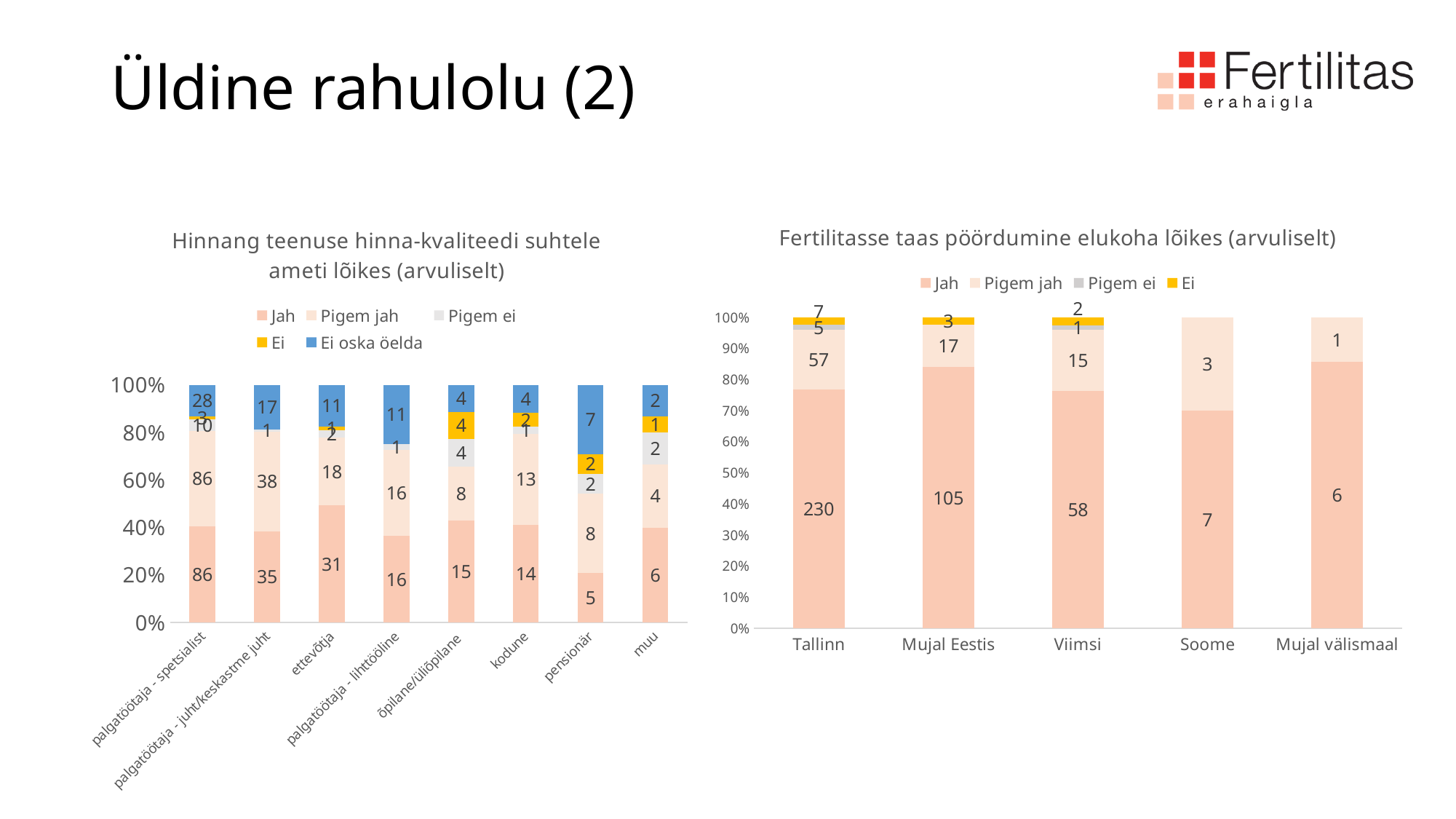
In the chart 'Hinnang teenuse hinna-kvaliteedi suhtele ameti lõikes (arvuliselt)', how many series does the legend list? 5 In the chart 'Fertilitasse taas pöördumine elukoha lõikes (arvuliselt)', what is the 'Jah' value for Tallinn? 230 In the chart 'Hinnang teenuse hinna-kvaliteedi suhtele ameti lõikes (arvuliselt)', what is the 'Jah' value for 'ettevõtja'? 31 In the chart 'Fertilitasse taas pöördumine elukoha lõikes (arvuliselt)', what is the 'Pigem jah' value for Viimsi? 15 In the chart 'Hinnang teenuse hinna-kvaliteedi suhtele ameti lõikes (arvuliselt)', which is larger: the 'Pigem jah' value for 'pensionär' or the 'Pigem jah' value for 'muu'? pensionär What type of chart is 'Hinnang teenuse hinna-kvaliteedi suhtele ameti lõikes (arvuliselt)'? Stacked bar chart In the chart 'Fertilitasse taas pöördumine elukoha lõikes (arvuliselt)', how many series does the legend list? 4 In the chart 'Fertilitasse taas pöördumine elukoha lõikes (arvuliselt)', how many locations are shown on the x axis? 5 In the chart 'Fertilitasse taas pöördumine elukoha lõikes (arvuliselt)', which location has the highest 'Jah' value? Tallinn In the chart 'Hinnang teenuse hinna-kvaliteedi suhtele ameti lõikes (arvuliselt)', what is the difference between the 'Jah' values for 'palgatöötaja - spetsialist' and 'palgatöötaja - juht/keskastme juht'? 51 In the chart 'Hinnang teenuse hinna-kvaliteedi suhtele ameti lõikes (arvuliselt)', what is the 'Ei oska öelda' value for 'palgatöötaja - spetsialist'? 28 In the chart 'Fertilitasse taas pöördumine elukoha lõikes (arvuliselt)', what is the total count for Viimsi across all four responses? 76